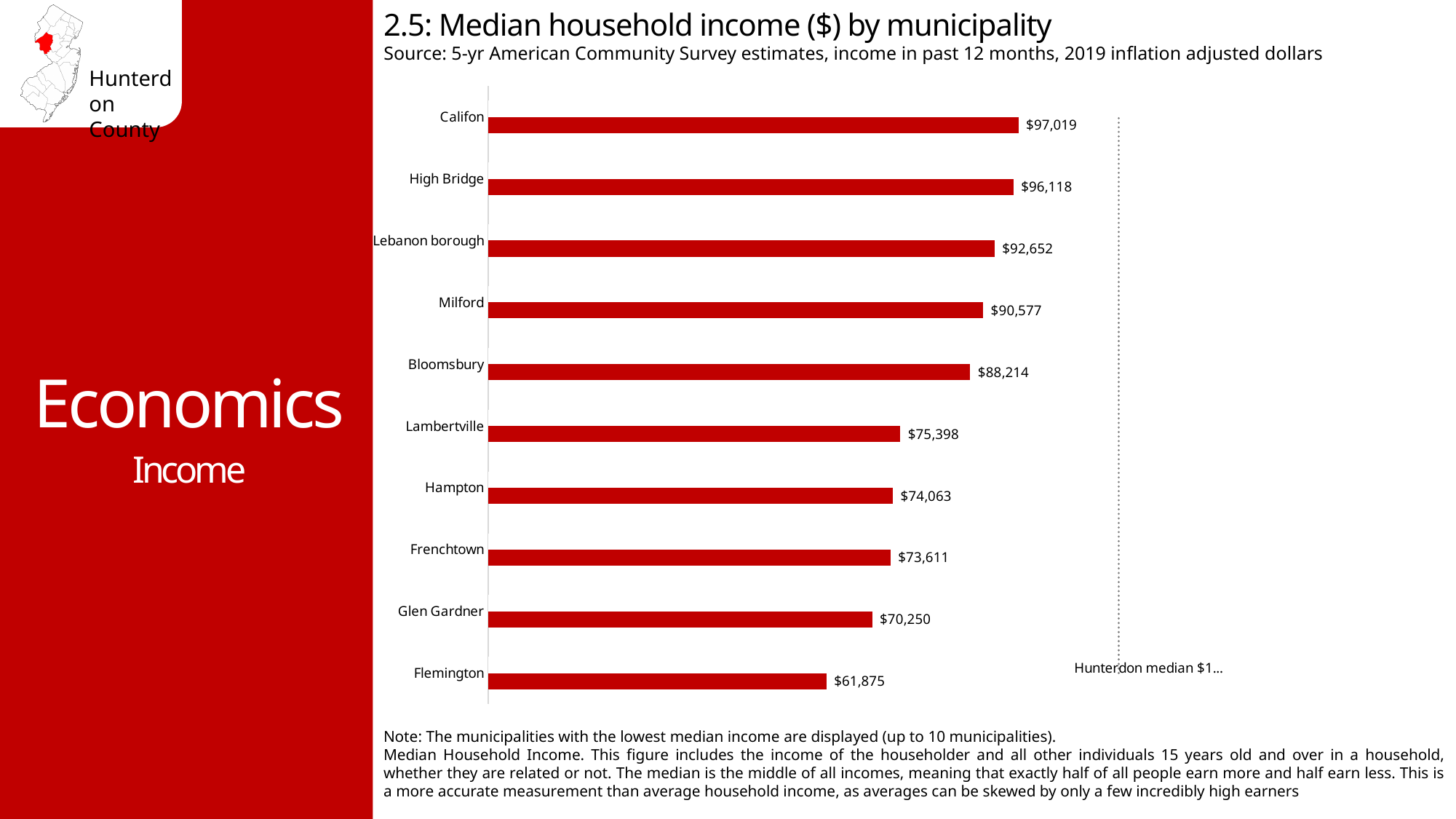
What is the median household income for Califon? $97,019 What is the median household income for Glen Gardner? $70,250 Which municipality has the lowest median household income shown on the chart? Flemington Which has a higher median household income, Hampton or Frenchtown? Hampton What is the title of the chart? 2.5: Median household income ($) by municipality What is the median household income for Flemington? $61,875 How many municipalities are shown on the chart? 10 What type of chart is used on this slide? Bar chart What is the difference in median household income between Califon and Flemington? $35,144 Which municipality has the highest median household income shown on the chart? Califon What is the difference in median household income between Milford and Bloomsbury? $2,363 What is the median household income for Lambertville? $75,398